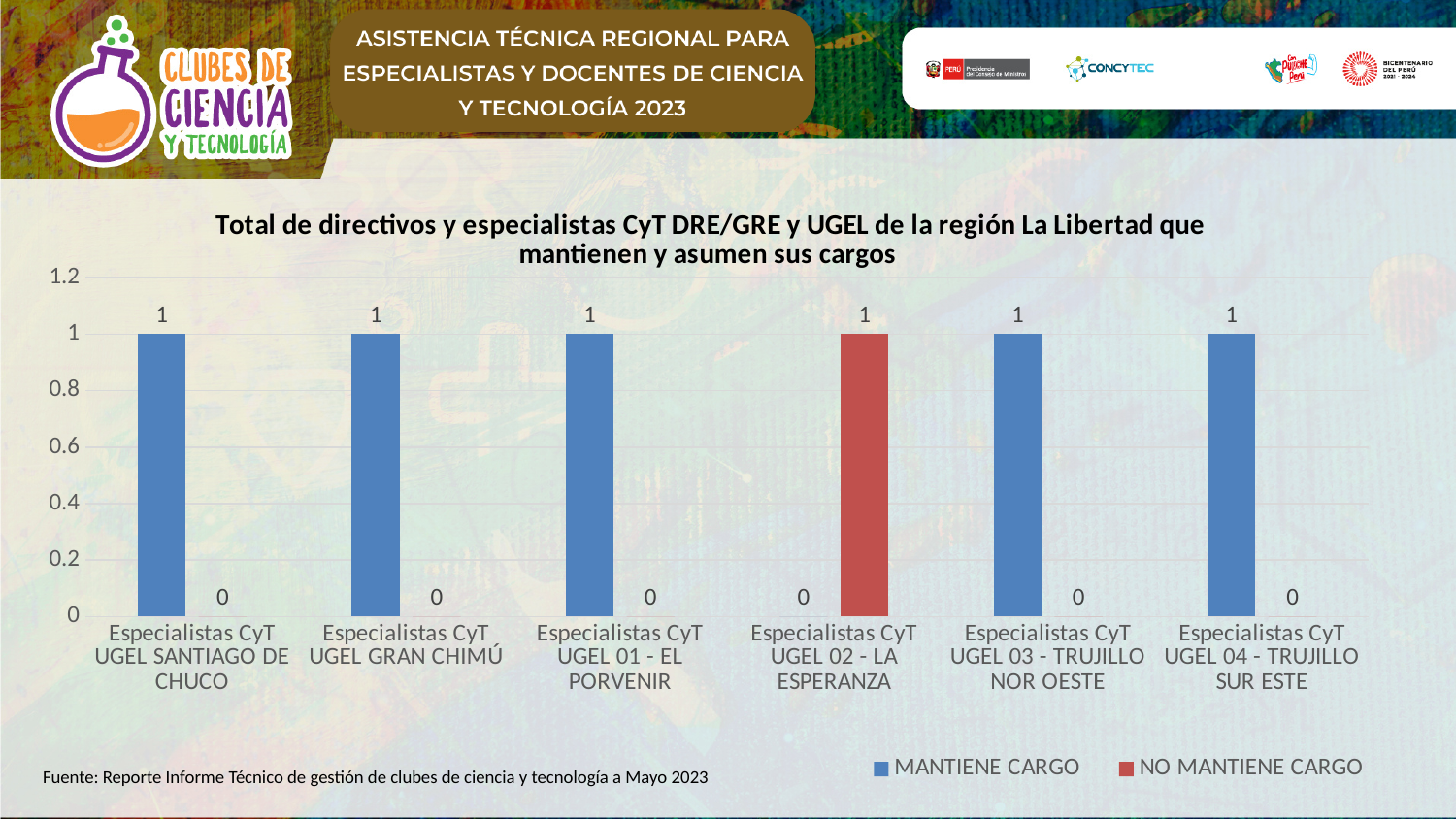
How many categories are shown on the x axis? 6 How many series does the legend list? 2 What is the MANTIENE CARGO value for Especialistas CyT UGEL SANTIAGO DE CHUCO? 1 What is the difference between the MANTIENE CARGO and NO MANTIENE CARGO values for Especialistas CyT UGEL 03 - TRUJILLO NOR OESTE? 1 What is the NO MANTIENE CARGO value for Especialistas CyT UGEL 02 - LA ESPERANZA? 1 Which series is shown in red in the legend? NO MANTIENE CARGO Which is larger for Especialistas CyT UGEL 04 - TRUJILLO SUR ESTE: MANTIENE CARGO or NO MANTIENE CARGO? MANTIENE CARGO What kind of chart is shown on the slide? bar chart What is the MANTIENE CARGO value for Especialistas CyT UGEL 02 - LA ESPERANZA? 0 What is the NO MANTIENE CARGO value for Especialistas CyT UGEL GRAN CHIMÚ? 0 Which category has the highest NO MANTIENE CARGO value? Especialistas CyT UGEL 02 - LA ESPERANZA Which category has the lowest MANTIENE CARGO value? Especialistas CyT UGEL 02 - LA ESPERANZA